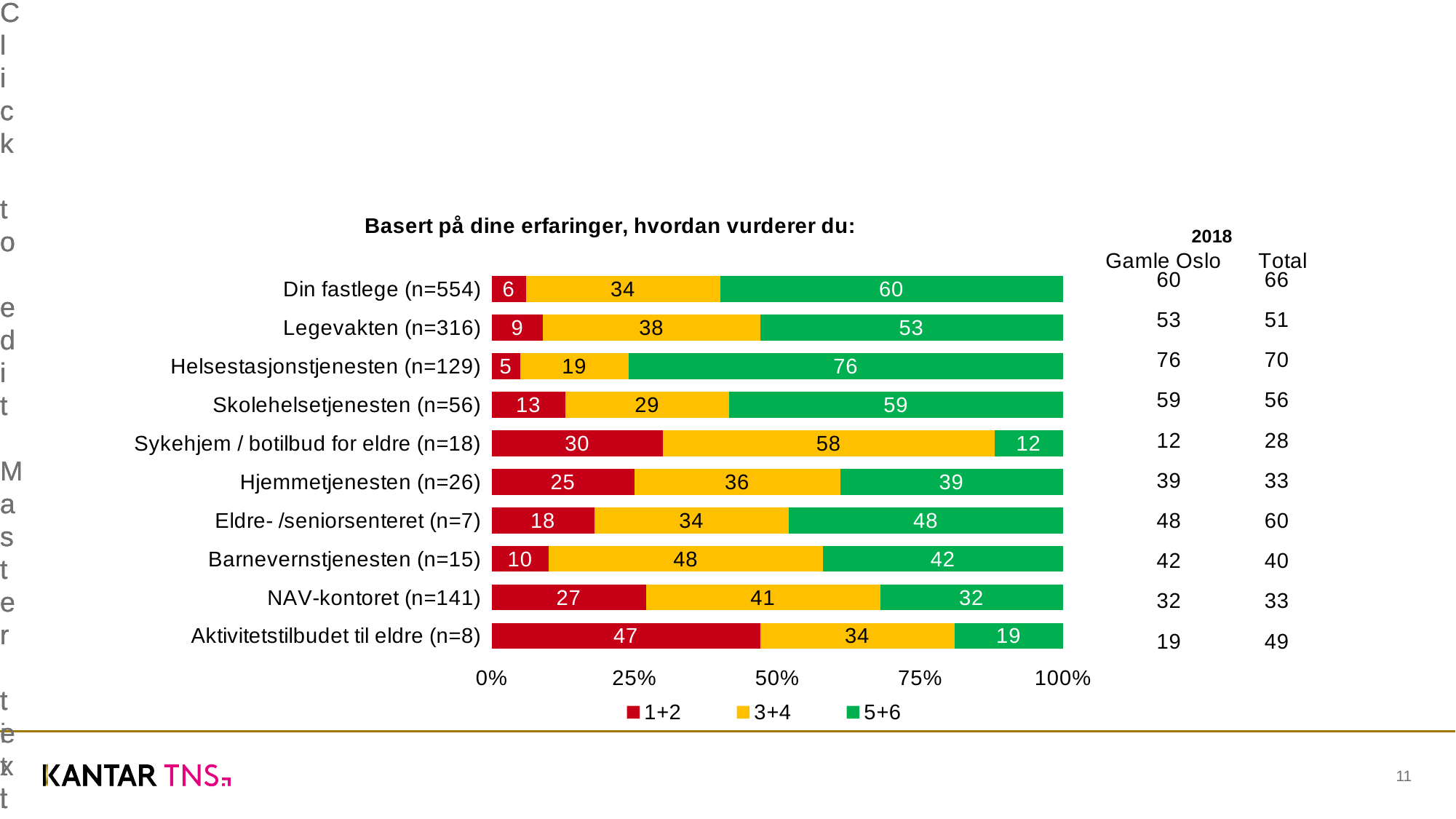
How many series does the legend list? 3 Which category has the highest value in the 1+2 series? Aktivitetstilbudet til eldre (n=8) What is the difference between the 5+6 values for Din fastlege (n=554) and Legevakten (n=316)? 7 Which category has the lowest value in the 5+6 series? Sykehjem / botilbud for eldre (n=18) What kind of chart is shown on the slide? Stacked bar chart What is the value of the 3+4 series for Sykehjem / botilbud for eldre (n=18)? 58 What is the value of the 5+6 series for Helsestasjonstjenesten (n=129)? 76 What is the value of the 1+2 series for Aktivitetstilbudet til eldre (n=8)? 47 Which category has the highest value in the 5+6 series? Helsestasjonstjenesten (n=129) How many categories are shown in the chart? 10 What is the total of the stacked bar for Din fastlege (n=554)? 100 Which has the larger 3+4 value, Barnevernstjenesten (n=15) or NAV-kontoret (n=141)? Barnevernstjenesten (n=15)